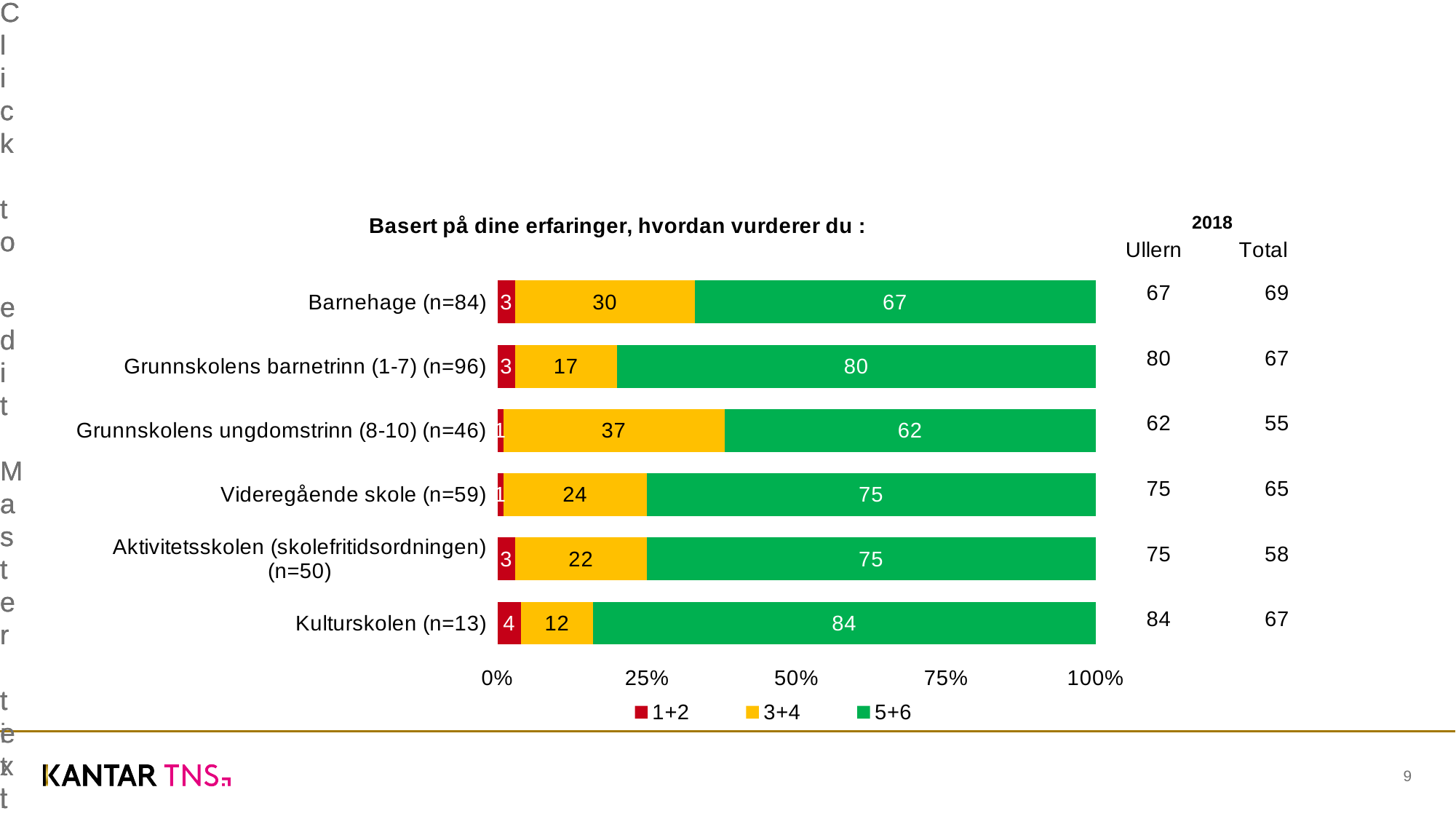
How many series does the legend list? 3 How many categories are shown on the chart? 6 Which is larger: the 3+4 value for Barnehage (n=84) or the 3+4 value for Grunnskolens barnetrinn (1-7) (n=96)? Barnehage (n=84) What kind of chart is shown on the slide? Stacked bar chart What is the value of the 1+2 series for Kulturskolen (n=13)? 4 What is the value of the 5+6 series for Barnehage (n=84)? 67 Which category has the highest value for the 5+6 series? Kulturskolen (n=13) What is the title of the chart? Basert på dine erfaringer, hvordan vurderer du : Which category has the lowest value for the 3+4 series? Kulturskolen (n=13) What is the value of the 3+4 series for Grunnskolens ungdomstrinn (8-10) (n=46)? 37 Which category has the lowest value for the 5+6 series? Grunnskolens ungdomstrinn (8-10) (n=46) What is the difference between the 5+6 values for Kulturskolen (n=13) and Grunnskolens ungdomstrinn (8-10) (n=46)? 22